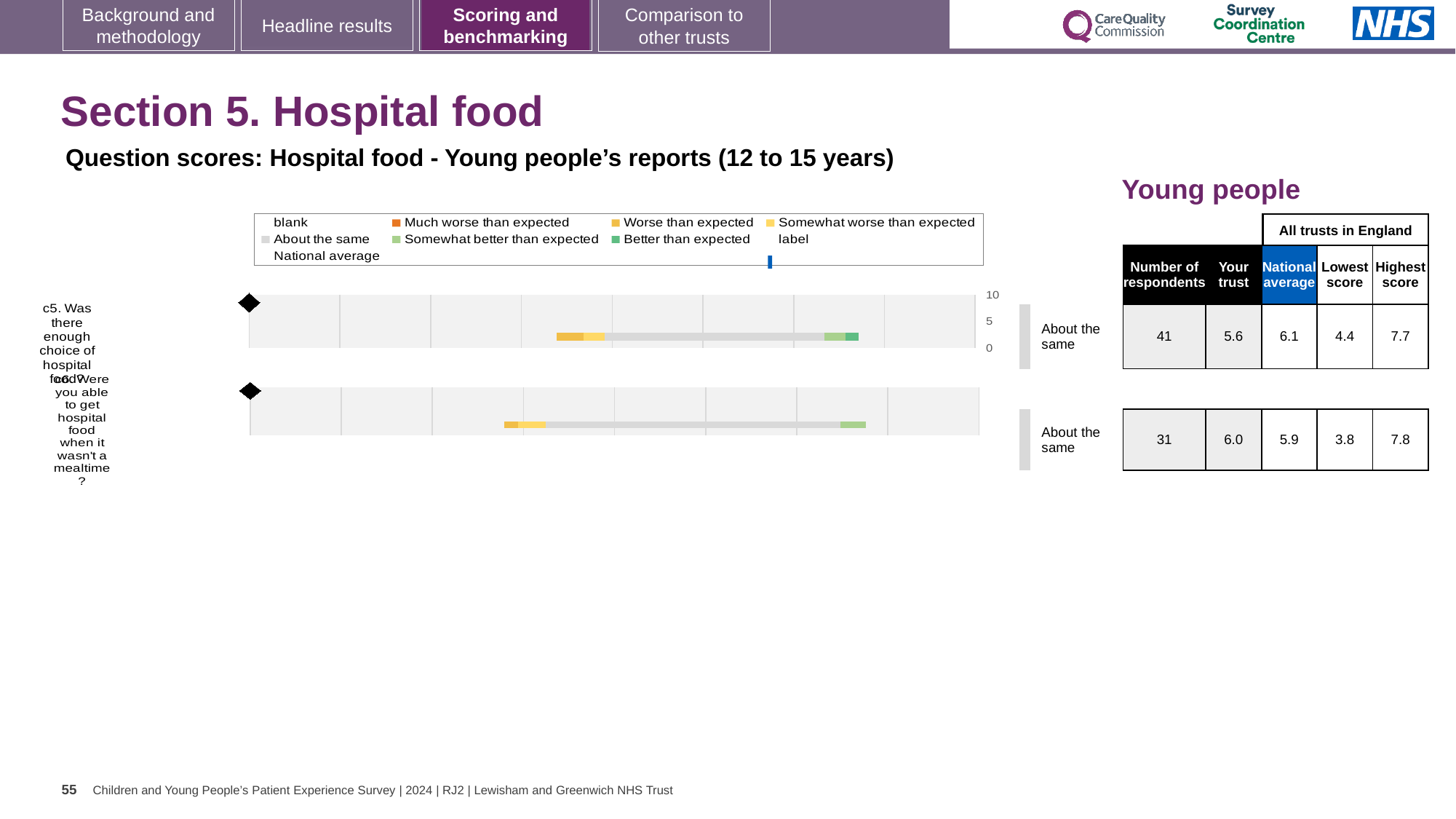
What is the difference between the highest score and the lowest score for question c5? 3.3 For question c5, which is larger: the trust's score or the national average? National average According to the table, what is the national average for question c5? 6.1 How many questions (categories) are plotted in the hospital food chart? 2 According to the table, what is the lowest score across all trusts in England for question c6? 3.8 What benchmark category is given for question c6? About the same Which legend entry is shown in dark green? Better than expected According to the table, what is the trust's score for question c6 about getting hospital food when it wasn't a mealtime? 6.0 According to the table, how many respondents answered question c5 about choice of hospital food? 41 What is the highest value shown on the chart's numeric axis? 10 How many entries does the chart legend list? 9 What kind of chart is used to show the question scores for hospital food? bar chart